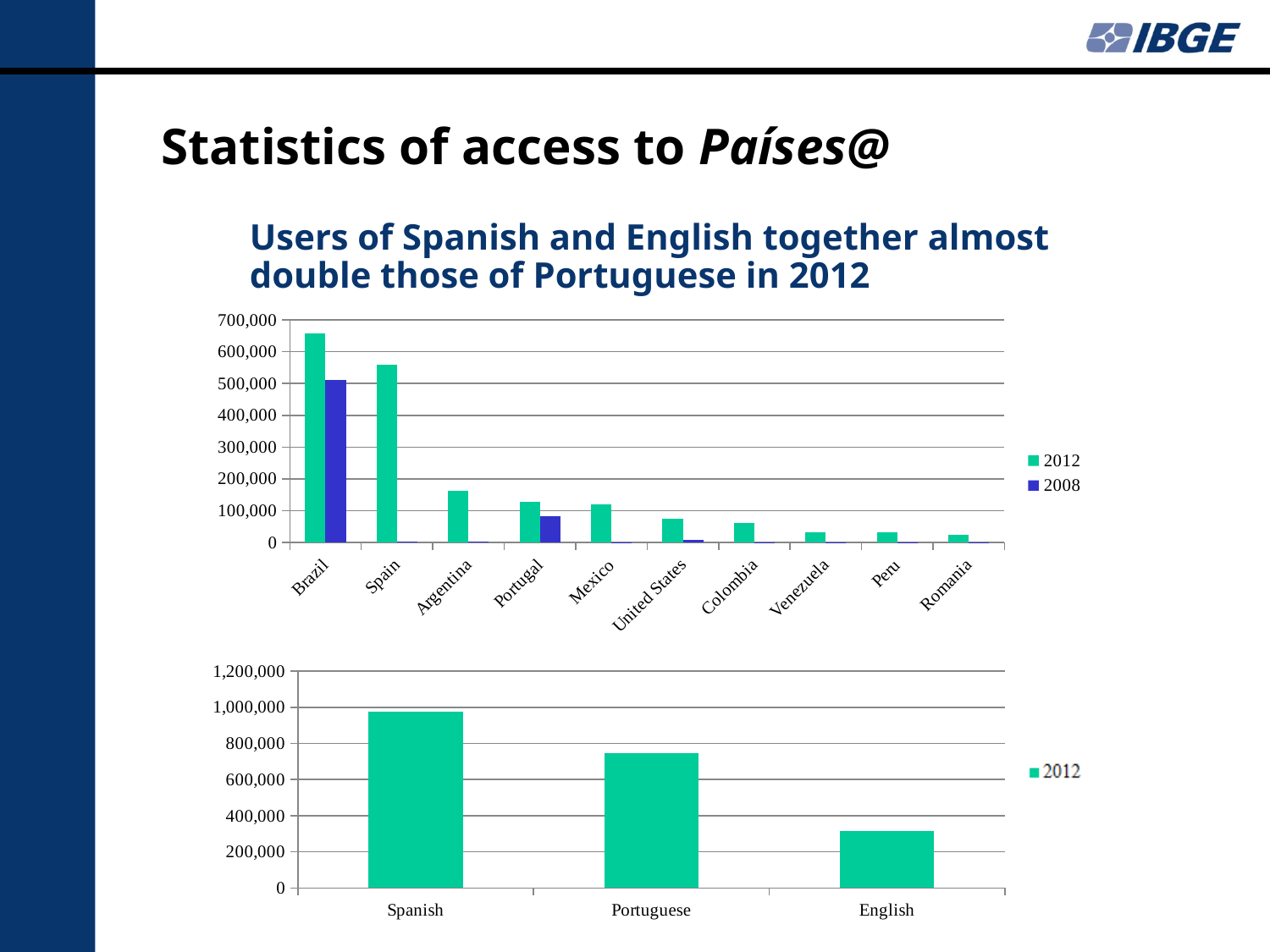
In the top chart, which country has the highest value for 2012? Brazil In the top chart, how many countries are shown on the x axis? 10 In the top chart, which is larger for 2012: Argentina or Portugal? Argentina In the top chart, is the 2012 value for Spain greater or less than 500,000? greater In the bottom chart, is the value for English greater or less than 400,000? less In the top chart, how many series does the legend list? 2 In the top chart, is the 2012 value for Brazil greater or less than 600,000? greater In the bottom chart, which language has the lowest value? English In the bottom chart, which language has the highest value? Spanish In the top chart, which years are listed in the legend? 2012 and 2008 What kind of chart is the bottom chart? bar chart